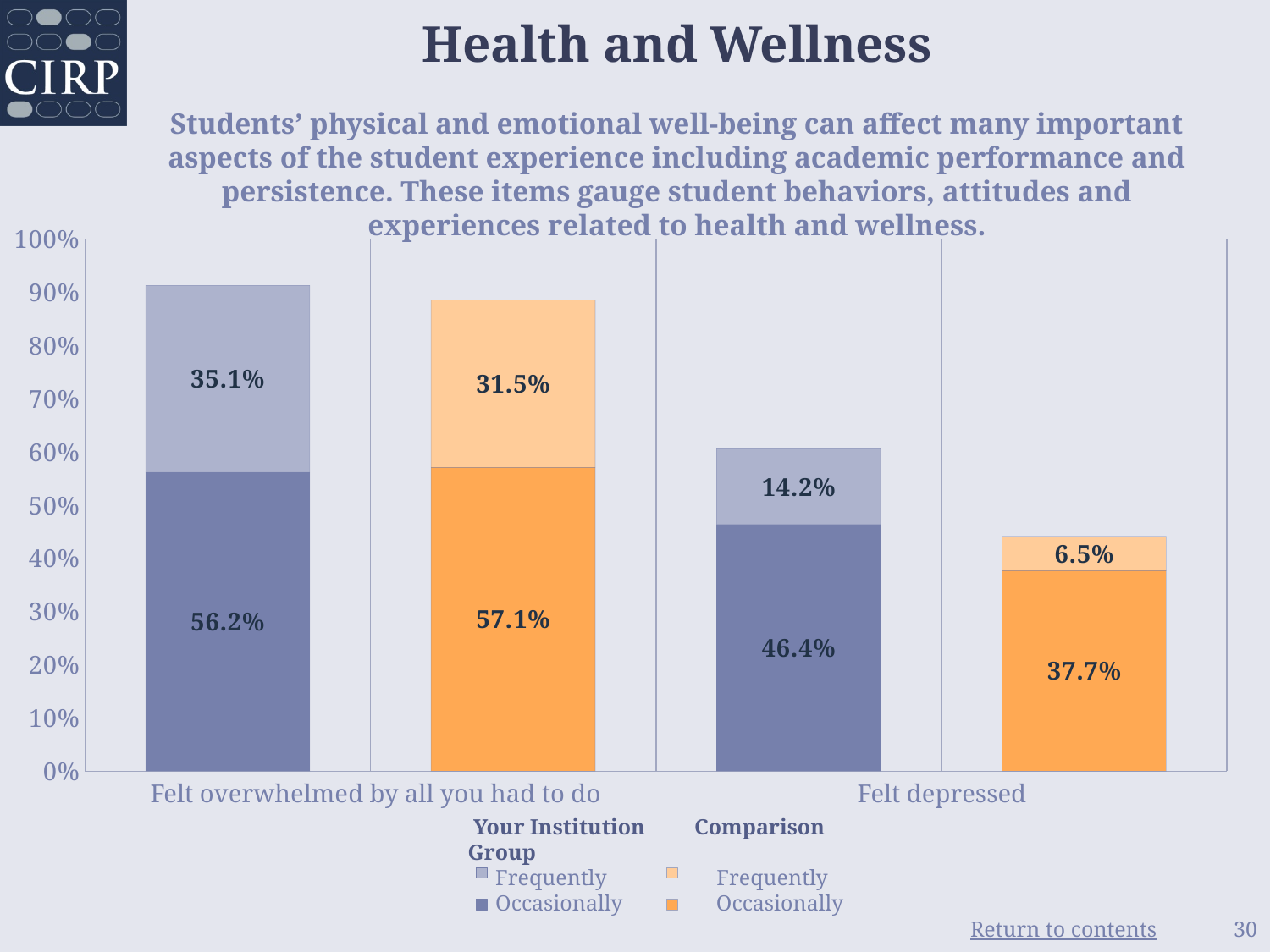
What percentage of Your Institution students reported frequently feeling overwhelmed by all they had to do? 35.1% What is the difference between the Your Institution and Comparison Group percentages for frequently feeling depressed? 7.7% How many series does the legend list? 4 Which stacked bar is the tallest overall? Your Institution, Felt overwhelmed by all you had to do What percentage of Comparison Group students reported frequently feeling depressed? 6.5% What percentage of Comparison Group students reported occasionally feeling depressed? 37.7% What is the total percentage of Comparison Group students who felt depressed (frequently plus occasionally)? 44.2% What kind of chart is shown on the slide? Stacked bar chart Which group has the larger percentage for occasionally feeling overwhelmed by all they had to do, Your Institution or Comparison Group? Comparison Group What percentage of Your Institution students reported occasionally feeling overwhelmed by all they had to do? 56.2% What is the total percentage of Your Institution students who felt overwhelmed by all they had to do (frequently plus occasionally)? 91.3% How many categories are shown on the x axis? 2